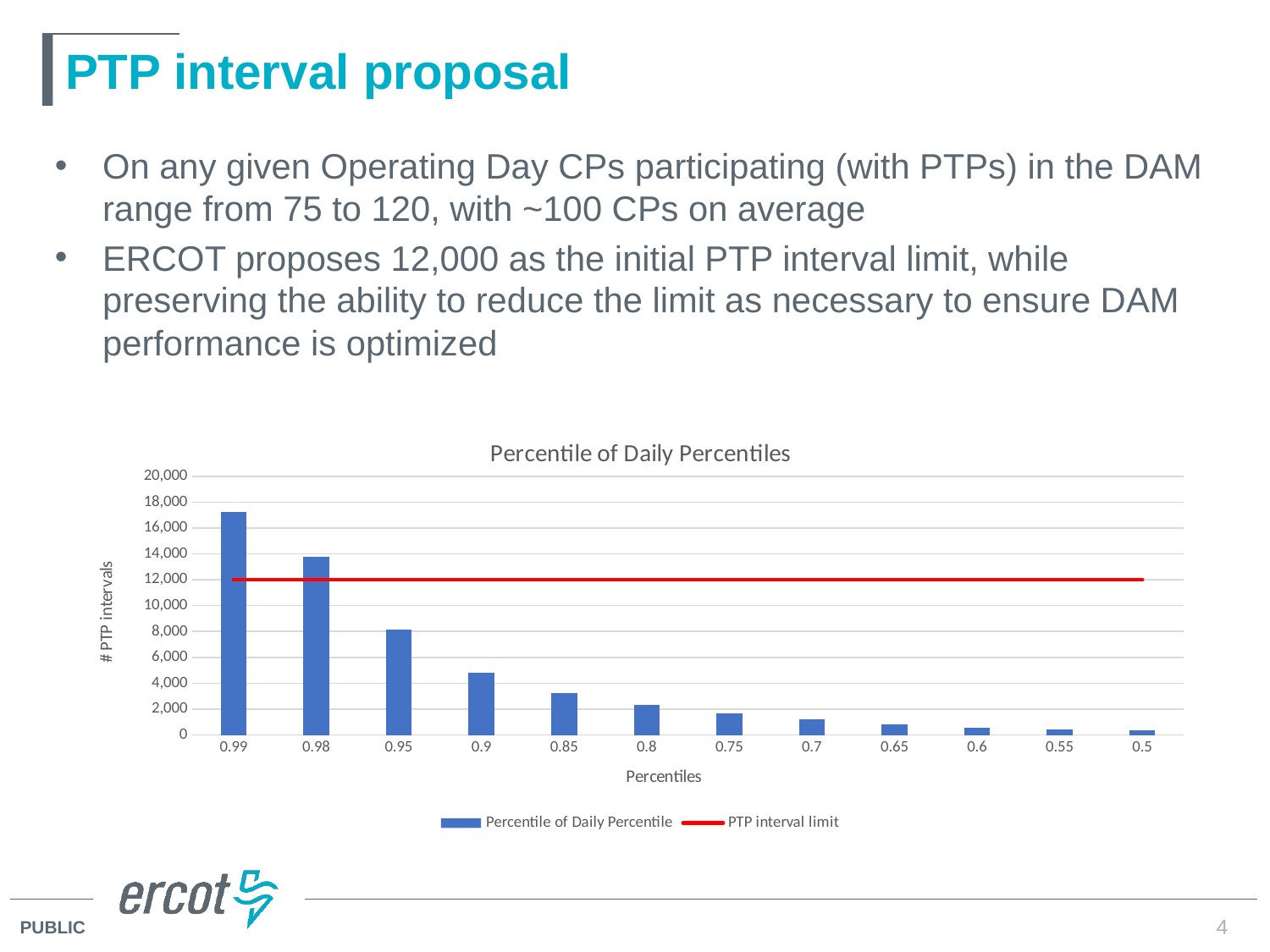
Is the value for the 0.98 percentile greater or less than 12,000? greater Do the bar values rise or fall moving from left to right along the x axis? fall What type of chart is shown on the slide? bar and line chart At what value on the y axis does the PTP interval limit line sit? 12,000 Which has more PTP intervals, the 0.95 percentile or the 0.85 percentile? 0.95 How many percentile categories are shown on the x axis of the chart? 12 What is the title of the chart? Percentile of Daily Percentiles Which percentile has the highest number of PTP intervals? 0.99 How many series does the chart legend list? 2 Is the value for the 0.99 percentile greater or less than 16,000? greater Which percentile has the lowest number of PTP intervals? 0.5 Is the value for the 0.9 percentile greater or less than 4,000? greater